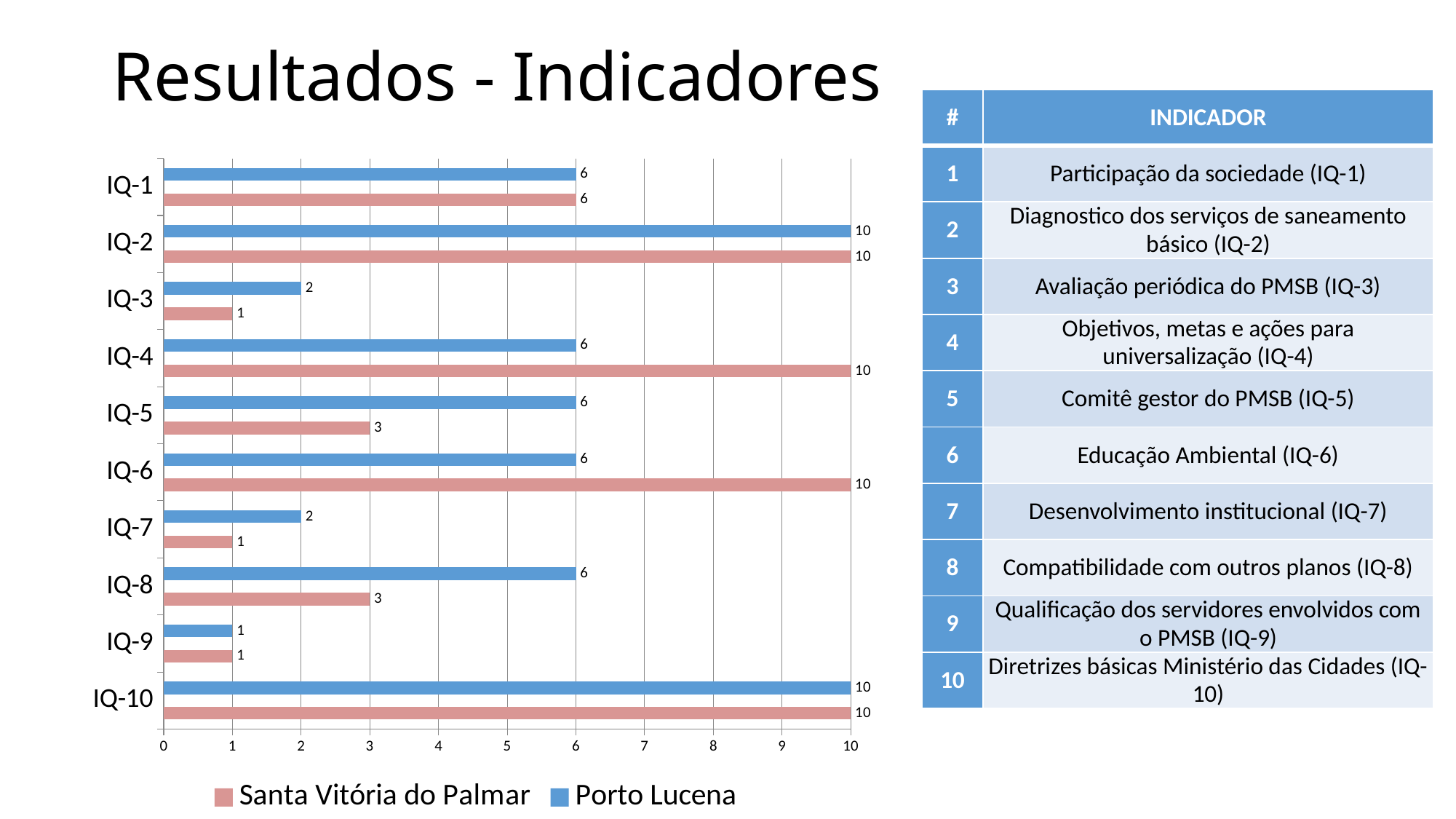
How many series does the chart legend list? 2 What is the value for Santa Vitória do Palmar on IQ-8? 3 Which indicator has the lowest value for Porto Lucena? IQ-9 What is the value for Santa Vitória do Palmar on IQ-4? 10 What type of chart is shown on the slide? Bar chart What is the value for Porto Lucena on IQ-9? 1 Which series has the larger value on IQ-4, Santa Vitória do Palmar or Porto Lucena? Santa Vitória do Palmar What is the difference between Santa Vitória do Palmar and Porto Lucena on IQ-6? 4 What is the value for Porto Lucena on IQ-5? 6 Which colour represents Santa Vitória do Palmar in the chart? Pink (red) Which series has the larger value on IQ-3, Santa Vitória do Palmar or Porto Lucena? Porto Lucena How many indicator categories (IQ) are plotted on the chart? 10